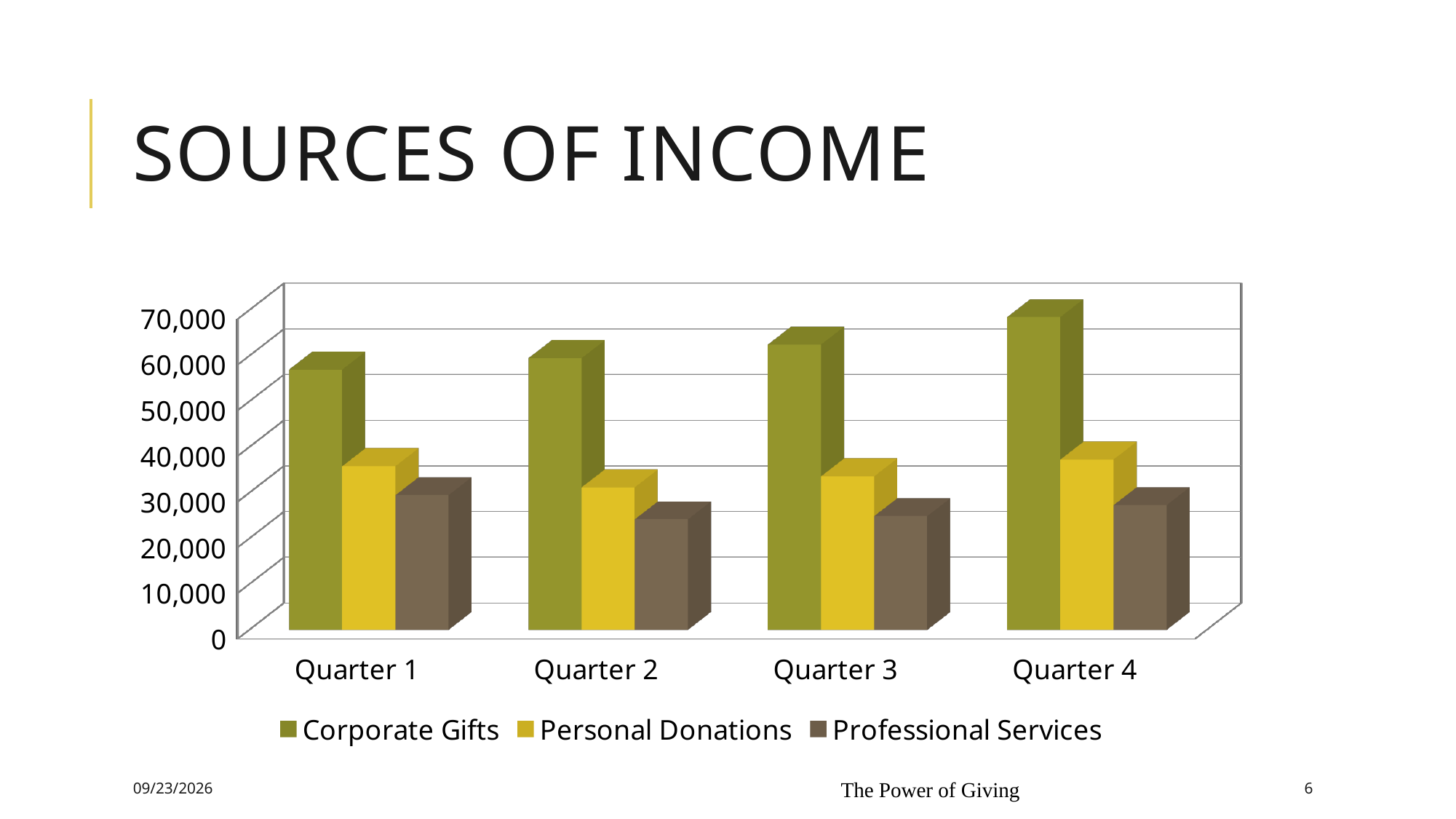
Is the value for Corporate Gifts in Quarter 1 greater or less than 50,000? greater Do the Corporate Gifts values rise or fall from Quarter 1 to Quarter 4? Rise How many series does the chart's legend list? 3 How many quarters are shown on the x axis of the chart? 4 Is the value for Corporate Gifts in Quarter 4 greater or less than 60,000? greater Is the value for Personal Donations in Quarter 2 greater or less than 40,000? less What kind of chart is shown on the slide? Bar chart In which quarter is Corporate Gifts highest? Quarter 4 Which is larger for Corporate Gifts: Quarter 1 or Quarter 4? Quarter 4 What is the title of the slide containing the chart? Sources of Income Which is larger in Quarter 1: Personal Donations or Professional Services? Personal Donations